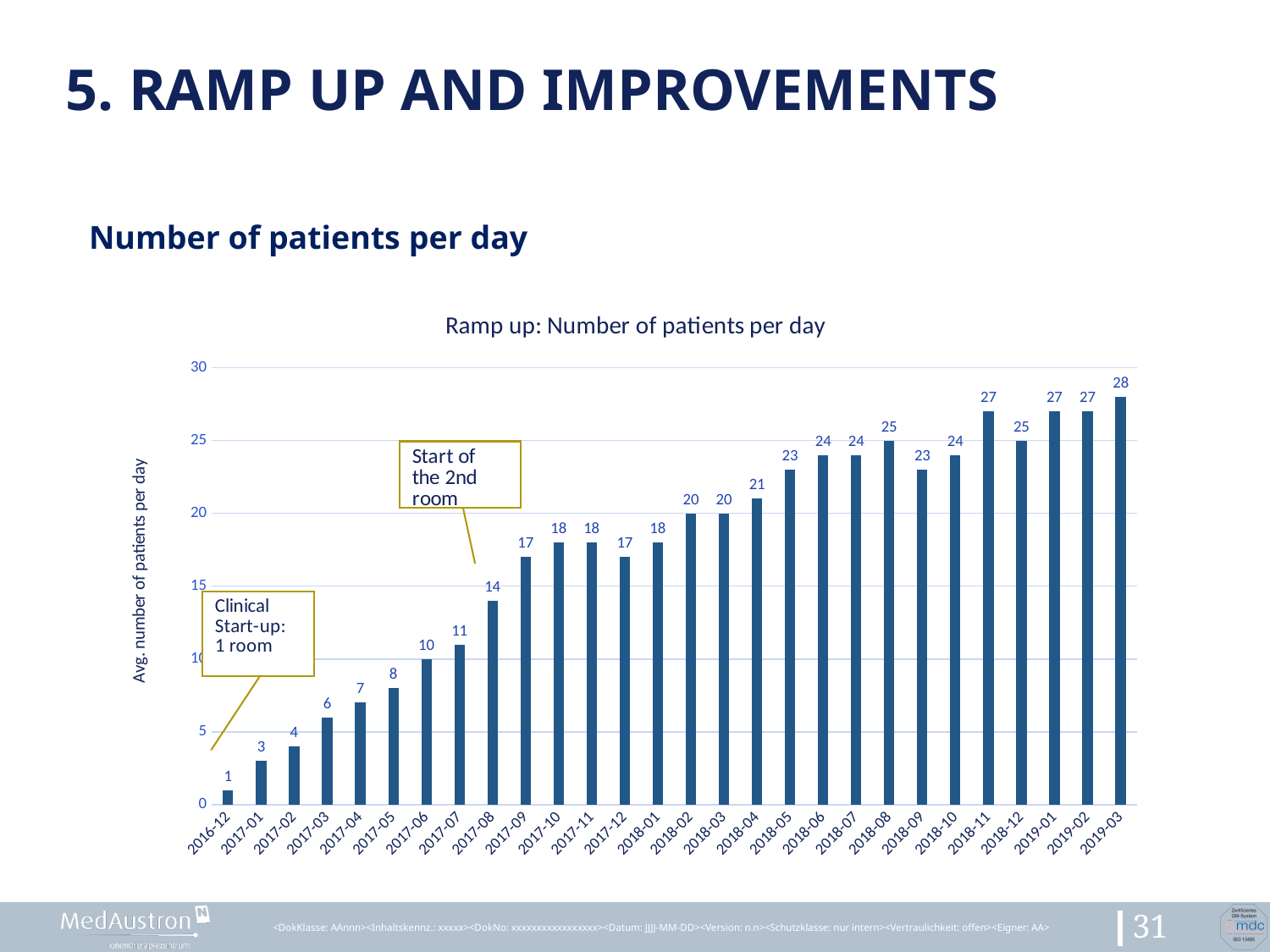
Which month has the highest average number of patients per day? 2019-03 What is the difference between the values for 2019-03 and 2016-12? 27 What value is shown for 2018-09? 23 What kind of chart is shown on the slide? Bar chart Which month has the lowest average number of patients per day? 2016-12 How many months (bars) are plotted in the chart? 28 What is the average number of patients per day shown for 2017-08? 14 What value is shown for 2018-04? 21 Do the values generally rise or fall from 2016-12 to 2019-03? Rise By how much does the value for 2018-11 exceed the value for 2018-12? 2 Which is larger, the value for 2017-12 or the value for 2018-02? 2018-02 What is the title of the chart? Ramp up: Number of patients per day